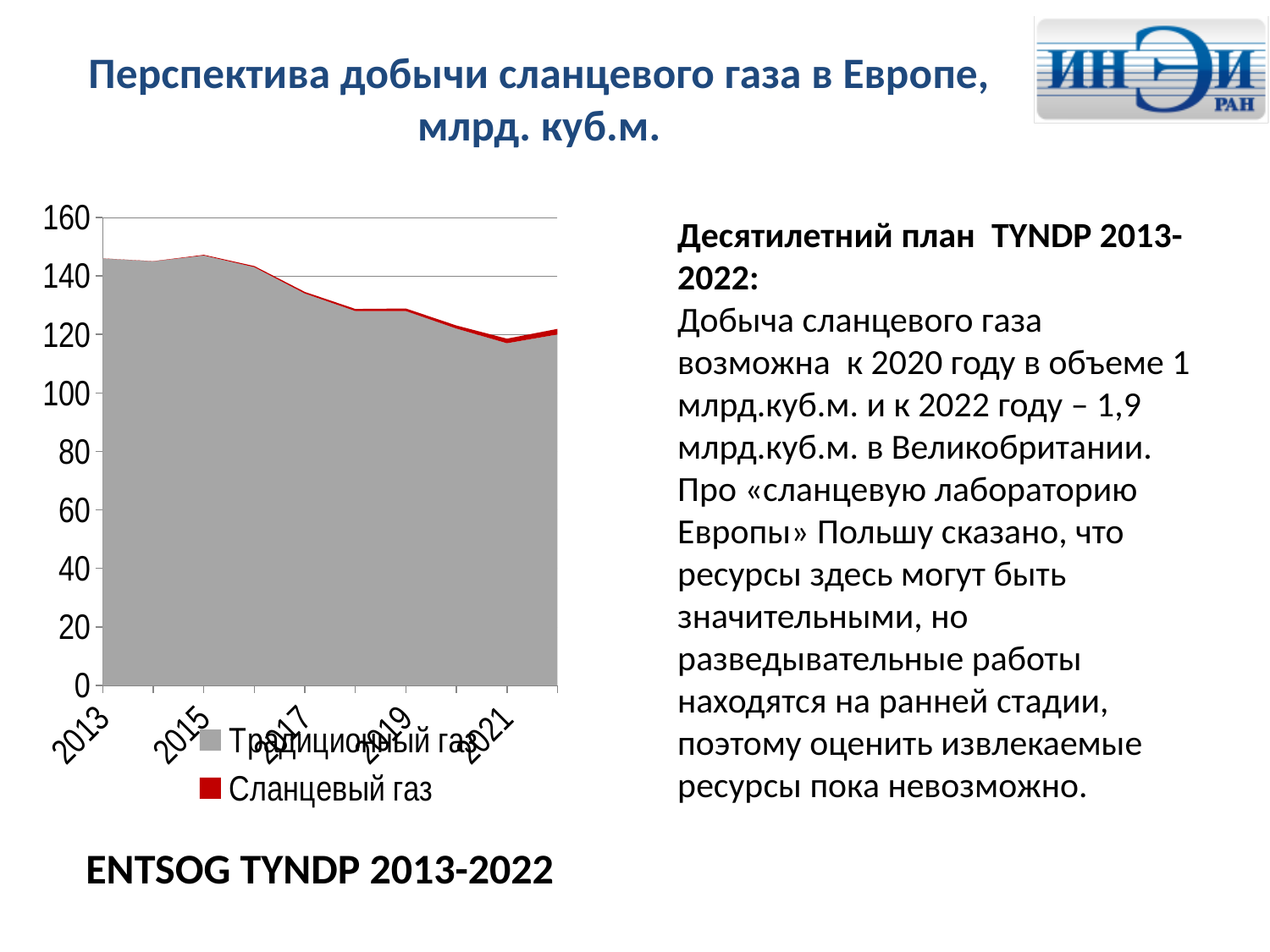
How many series does the chart legend list? 2 Is the total value for 2019 greater or less than 140? less What kind of chart is shown on the slide? area chart Does the total gas production in the chart rise or fall from 2013 to 2021? fall Is the total value for 2013 greater or less than 140? greater Is the total value for 2019 greater or less than 120? greater What are the two series named in the chart legend? Традиционный газ, Сланцевый газ Which colour represents Сланцевый газ in the chart? red What is the highest value shown on the y axis of the chart? 160 How many year labels are shown on the x axis of the chart? 5 Which series is larger in 2021, Традиционный газ or Сланцевый газ? Традиционный газ